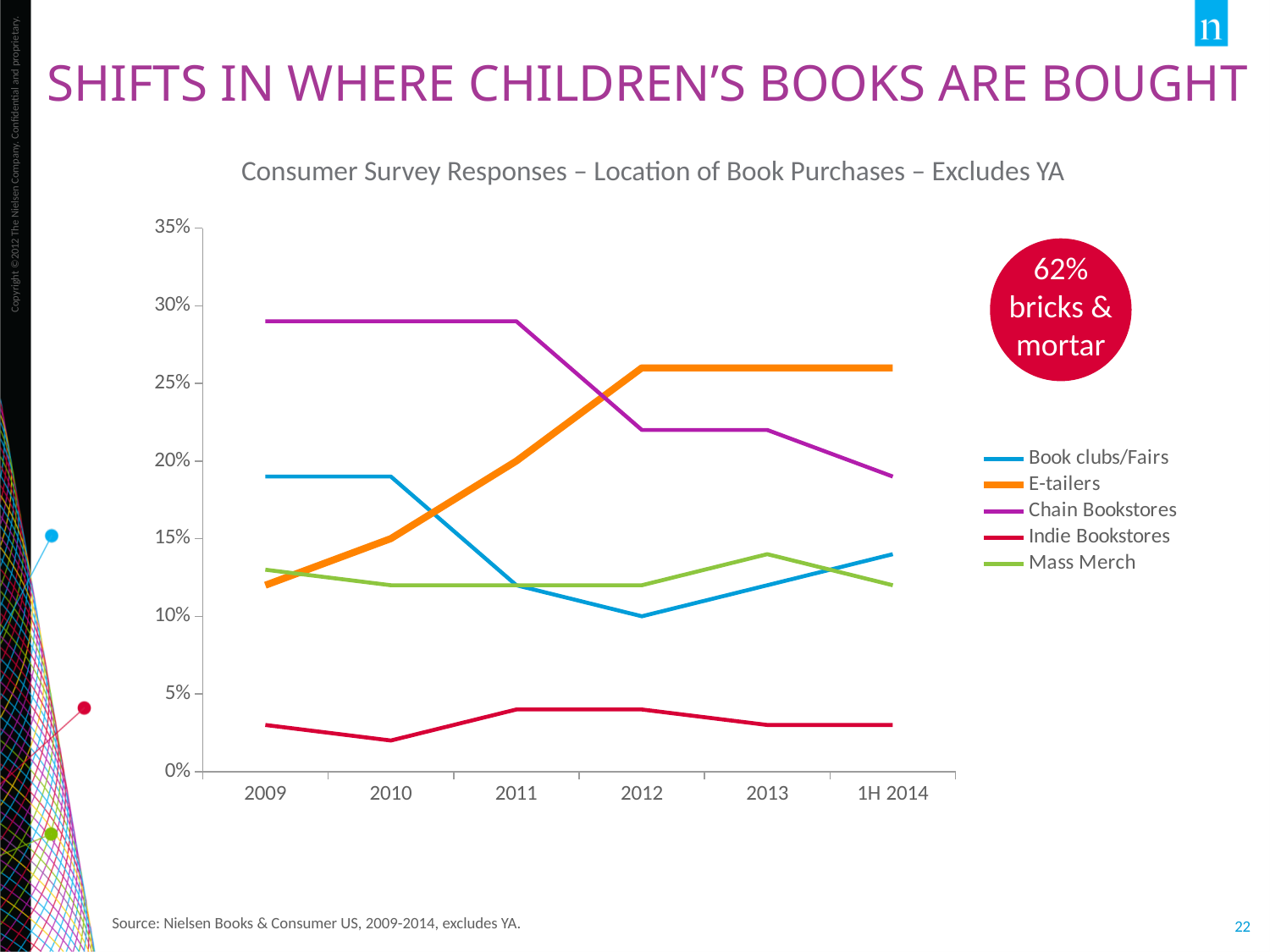
Is the value for Indie Bookstores in 2013 greater or less than 5%? less What percentage is shown in the red circle callout next to the chart? 62% Which series has the lowest value in 2012? Indie Bookstores Does the Chain Bookstores line rise or fall from 2009 to 1H 2014? Fall Is the value for Book clubs/Fairs in 2012 greater or less than 15%? less Which series has the highest value in 1H 2014? E-tailers Which series has the highest value in 2009? Chain Bookstores How many time periods are shown along the x axis? 6 Is the value for Chain Bookstores in 2009 greater or less than 25%? greater How many series does the legend list? 5 In 2011, which is larger: E-tailers or Book clubs/Fairs? E-tailers What kind of chart is shown on the slide? Line chart